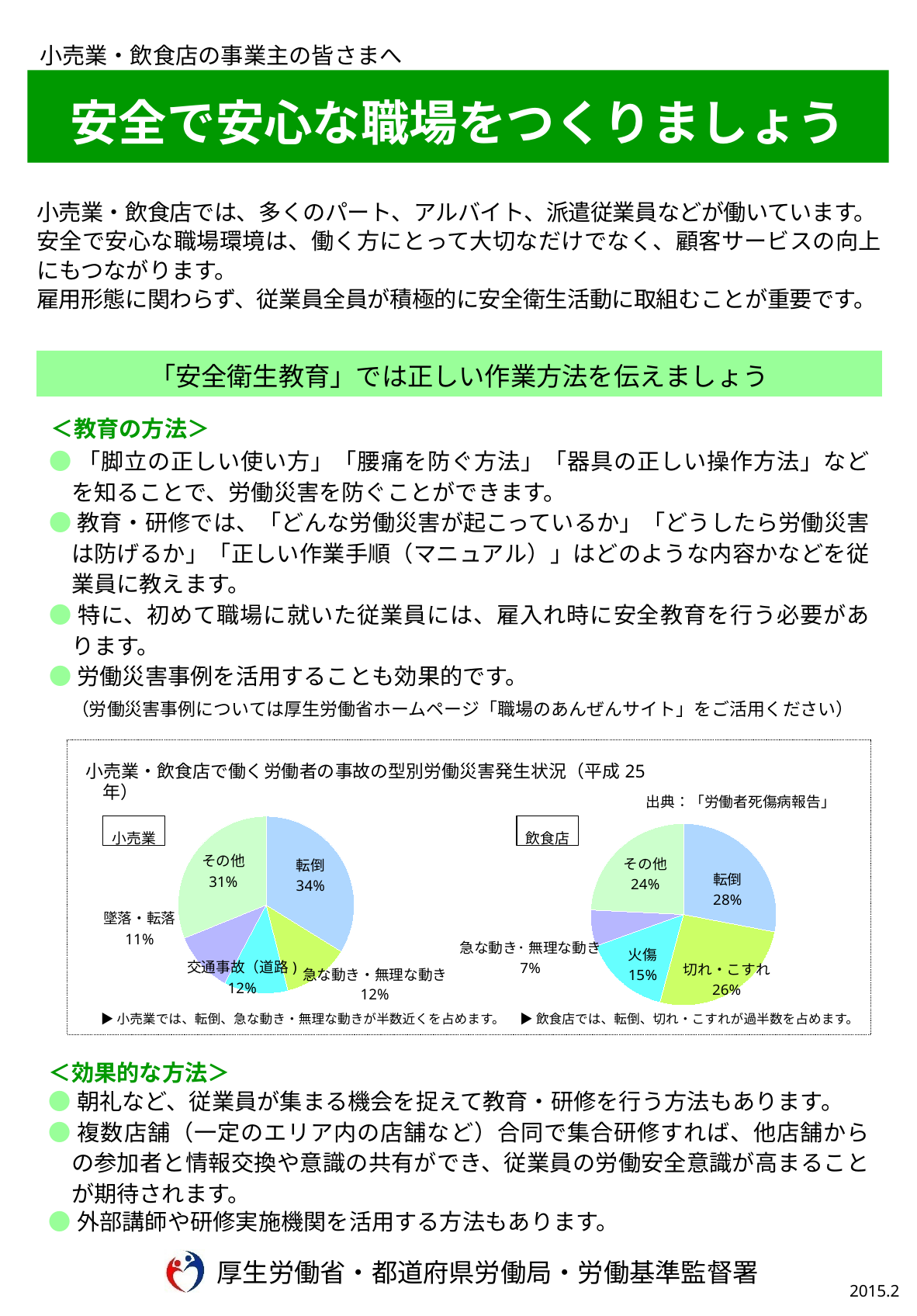
In the 小売業 pie chart, what is the difference between 転倒 and その他? 3% In the 飲食店 pie chart, what is the difference between 転倒 and 火傷? 13% What is the source cited for the charts? 「労働者死傷病報告」 How many slices does the 飲食店 pie chart have? 5 In the 小売業 pie chart, what share is 転倒? 34% In the 飲食店 pie chart, what share is 火傷? 15% In the 飲食店 pie chart, which category has the smallest share? 急な動き・無理な動き In the 飲食店 pie chart, what share is 切れ・こすれ? 26% What type of chart is used for 小売業 and 飲食店? Pie chart In the 小売業 pie chart, what share is 墜落・転落? 11% Which is larger: 急な動き・無理な動き in the 小売業 chart or in the 飲食店 chart? 小売業 In the 小売業 pie chart, which category has the largest share? 転倒